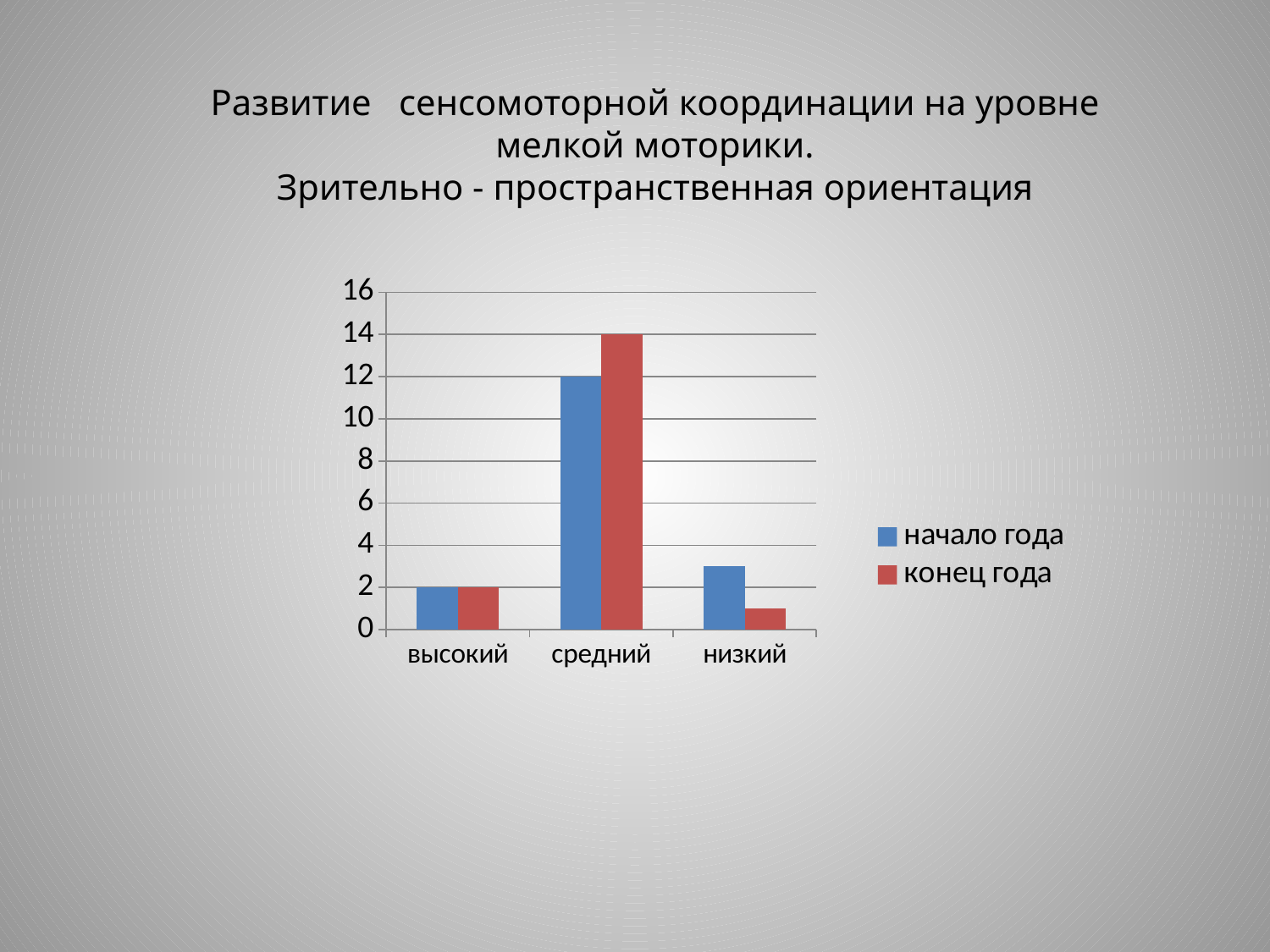
How many series does the legend list? 2 Which category has the lowest value in the конец года series? низкий What is the difference between the конец года and начало года values for средний? 2 What is the value for средний in the начало года series? 12 What is the value for средний in the конец года series? 14 Is the value for низкий in the начало года series greater or less than 2? greater Which category has the highest value in the конец года series? средний What kind of chart is shown on the slide? bar chart What is the value for высокий in the конец года series? 2 What is the value for высокий in the начало года series? 2 Which series is shown in red in the legend? конец года How many categories are shown on the x axis? 3